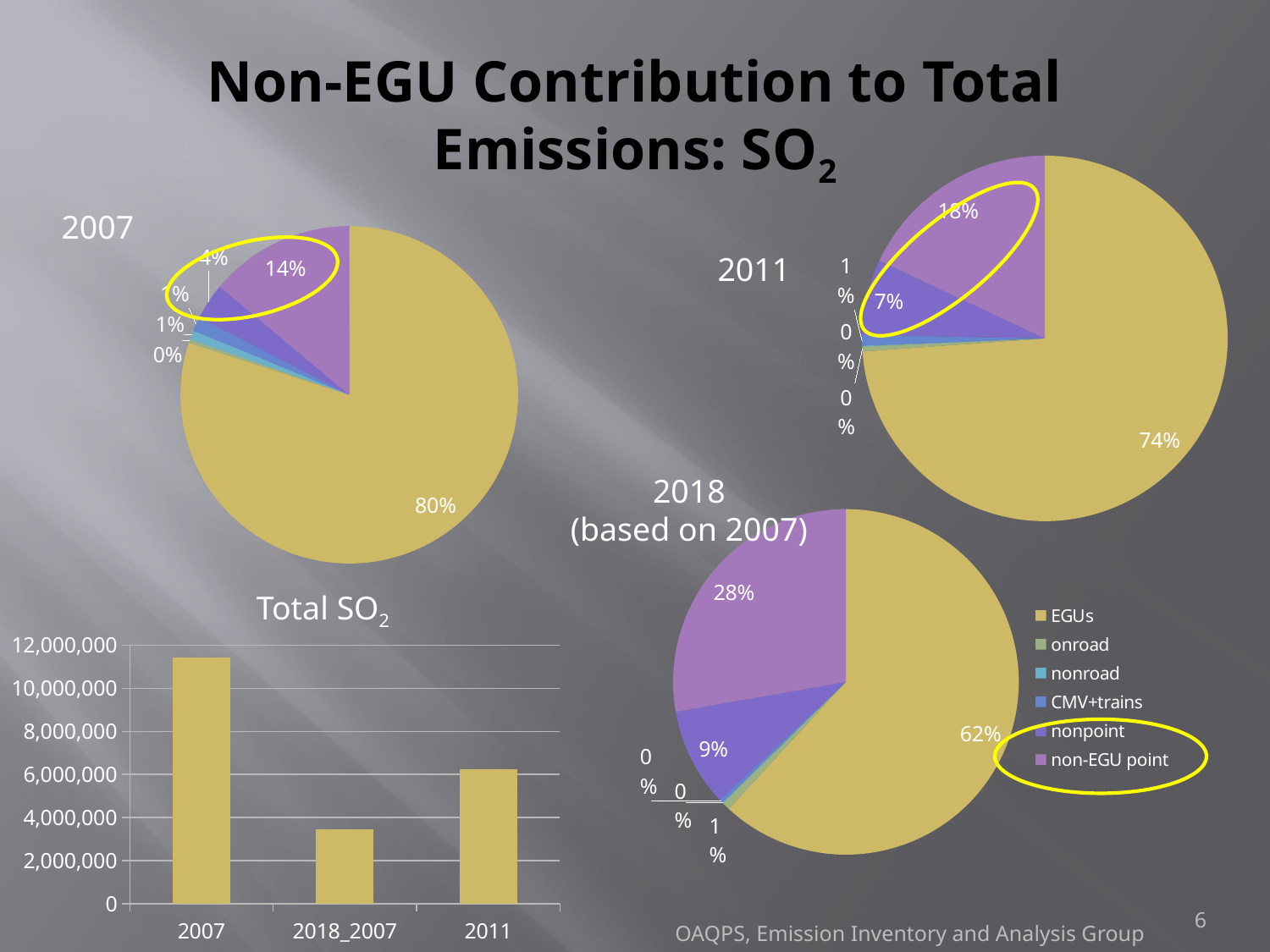
In the Total SO2 bar chart, is the value for 2007 greater or less than 10,000,000? greater How many categories are shown on the x axis of the Total SO2 bar chart? 3 In the 2018 (based on 2007) pie chart, what is the difference in percentage points between the EGUs slice (62%) and the non-EGU point slice (28%)? 34 In the 2011 pie chart, what share is labelled for the nonpoint slice? 7% In the 2018 (based on 2007) pie chart, which category has the largest slice? EGUs In the 2007 pie chart, what share of total SO2 emissions comes from EGUs? 80% In the 2011 pie chart, what share of total SO2 emissions comes from EGUs? 74% In the 2007 pie chart, what share is labelled for the non-EGU point slice? 14% In the 2018 (based on 2007) pie chart, what share is labelled for the non-EGU point slice? 28% In the Total SO2 bar chart, which is larger, the bar for 2011 or the bar for 2018_2007? 2011 How many series does the legend next to the 2018 pie chart list? 6 What kind of chart is the Total SO2 chart? bar chart